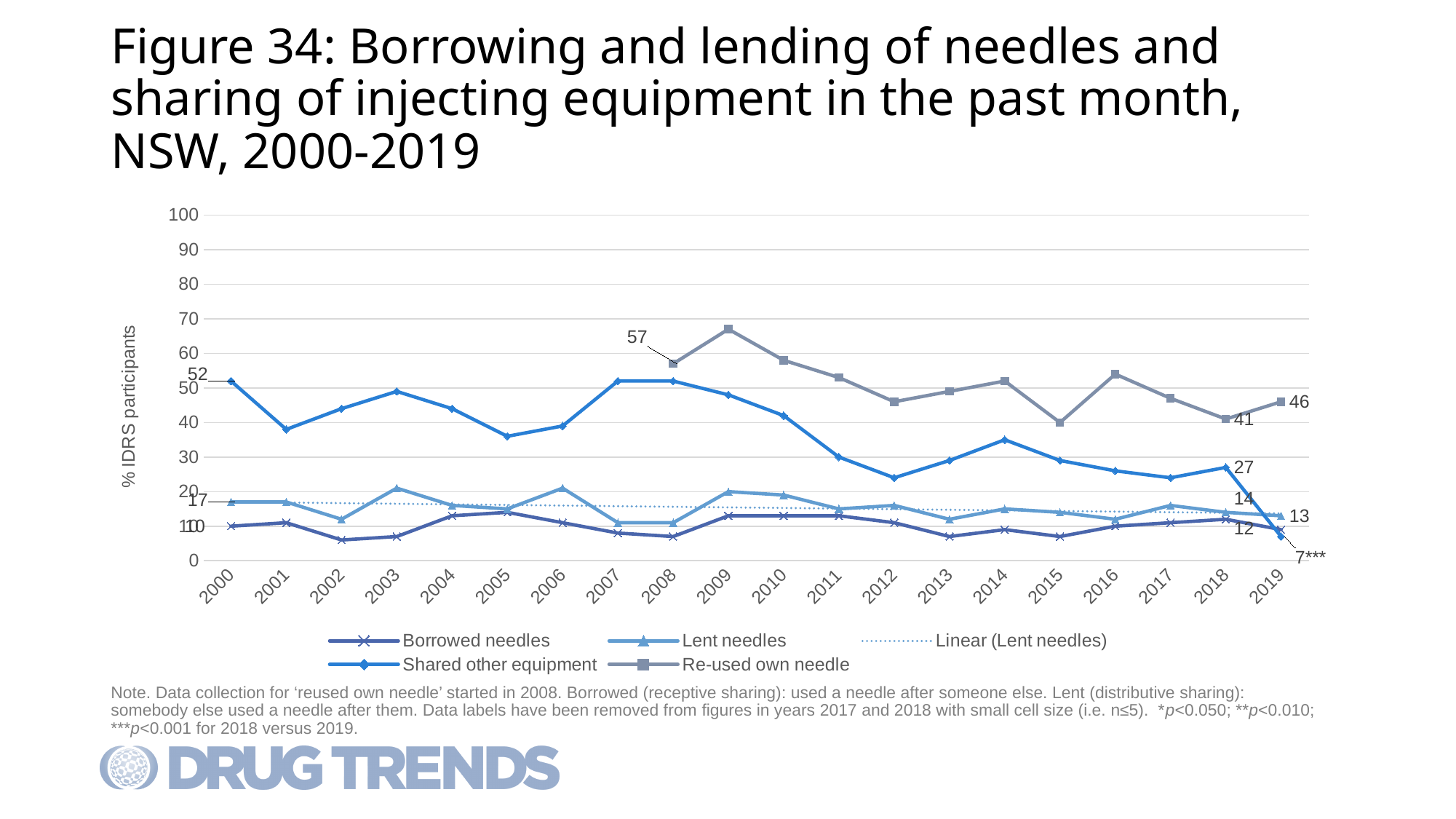
How many entries does the legend list? 5 What is the difference between the Shared other equipment values in 2000 and 2018? 25 What is the value for Shared other equipment in 2018? 27 Is the value for Re-used own needle in 2009 greater or less than 60? greater What is the value for Re-used own needle in 2019? 46 What is the value for Shared other equipment in 2000? 52 How many years are shown on the x axis? 20 What is the value for Lent needles in 2019? 13 In which year does the Re-used own needle series reach its highest value? 2009 What is the difference between the Re-used own needle values in 2019 and 2018? 5 What is the value for Re-used own needle in 2008? 57 In 2019, which is larger: Re-used own needle or Lent needles? Re-used own needle